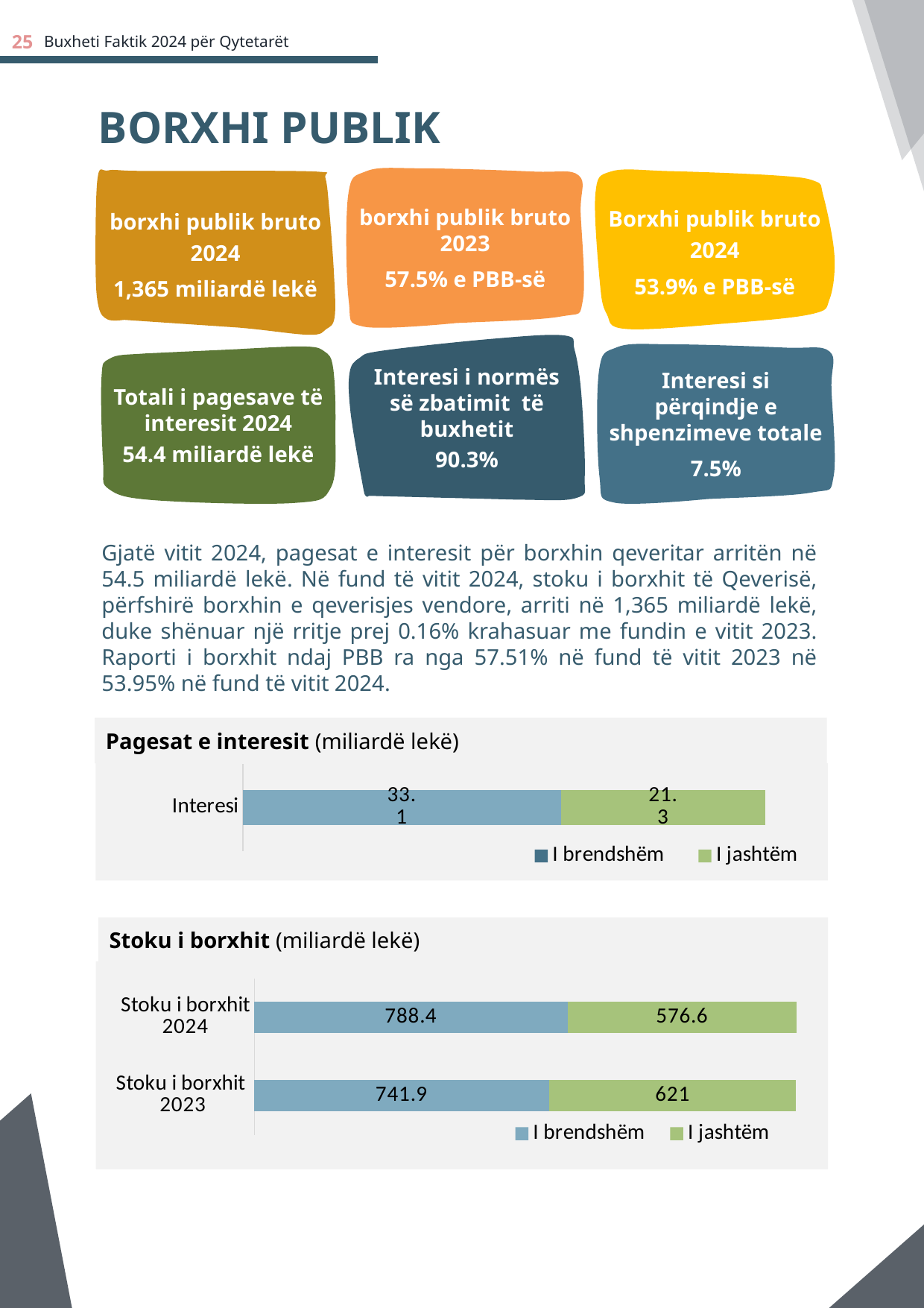
In the 'Stoku i borxhit' chart, which year has the larger 'I jashtëm' value, 2024 or 2023? 2023 In the 'Stoku i borxhit' chart, what is the total of the stacked bar for 'Stoku i borxhit 2024'? 1365.0 In the 'Stoku i borxhit' chart, how many series does the legend list? 2 In the 'Pagesat e interesit' chart, what is the total of the stacked bar for 'Interesi'? 54.4 In the 'Pagesat e interesit' chart, which series is larger, 'I brendshëm' or 'I jashtëm'? I brendshëm In the 'Pagesat e interesit' chart, what is the value for 'I brendshëm'? 33.1 In the 'Stoku i borxhit' chart, how many categories are shown? 2 In the 'Stoku i borxhit' chart, what is the difference between the 'I brendshëm' values for 2024 and 2023? 46.5 What type of chart is the 'Pagesat e interesit' chart? Stacked bar chart In the 'Stoku i borxhit' chart, what is the 'I jashtëm' value for 'Stoku i borxhit 2023'? 621 In the 'Stoku i borxhit' chart, what is the 'I brendshëm' value for 'Stoku i borxhit 2024'? 788.4 In the 'Pagesat e interesit' chart, what is the value for 'I jashtëm'? 21.3